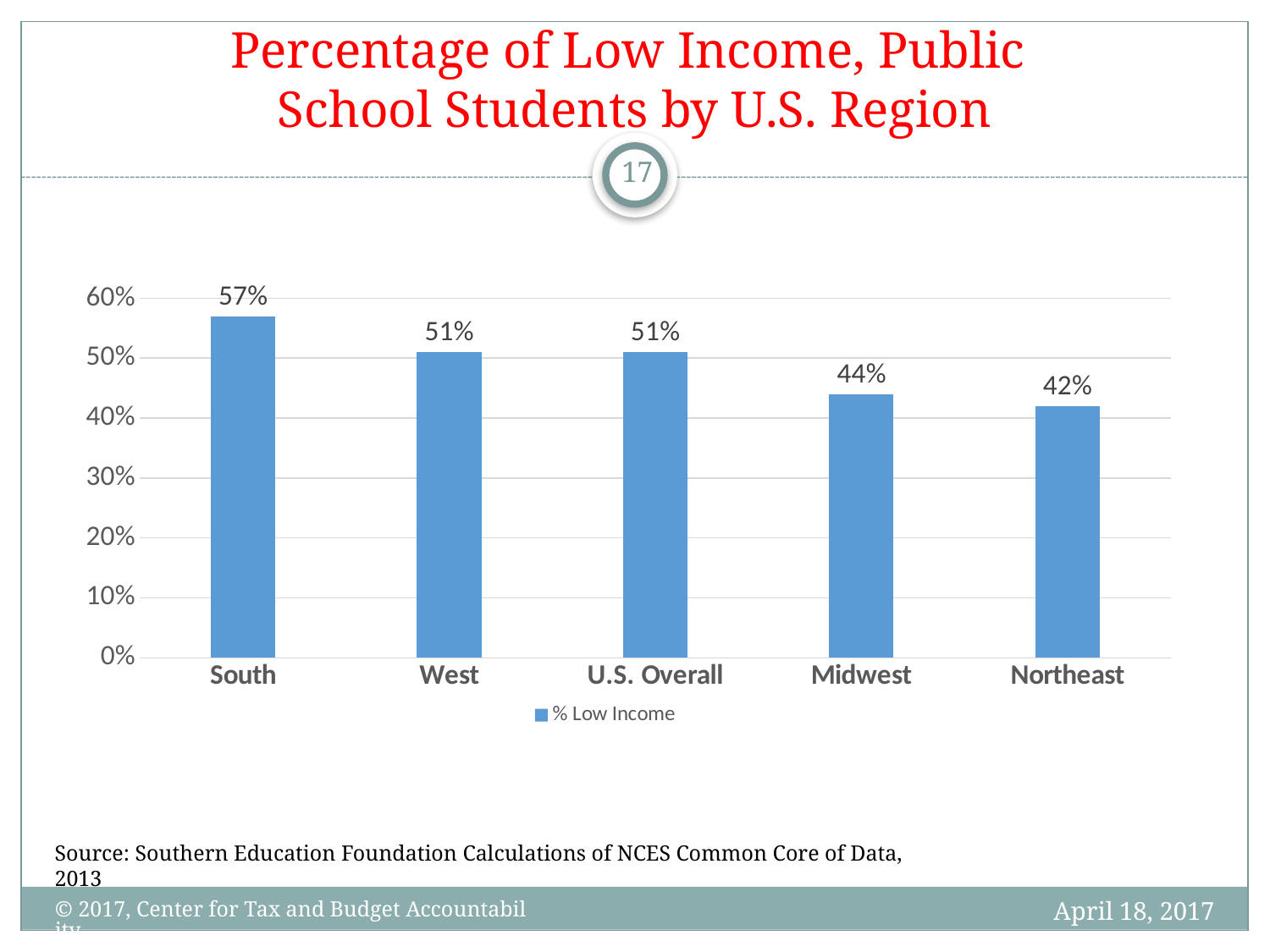
What kind of chart is shown on the slide? Bar chart How many regions/categories are shown on the x axis? 5 What is the percentage of low income public school students in the South? 57% What series name is listed in the legend? % Low Income What is the difference between the South and the Northeast values? 15% What is the percentage of low income public school students in the Midwest? 44% Which is larger, the value for the Midwest or the value for the Northeast? Midwest Which region has the highest percentage of low income students? South Which region has the lowest percentage of low income students? Northeast What is the difference between the West and the Midwest values? 7% Is the value for the Northeast greater or less than 50%? less What is the value shown for U.S. Overall? 51%